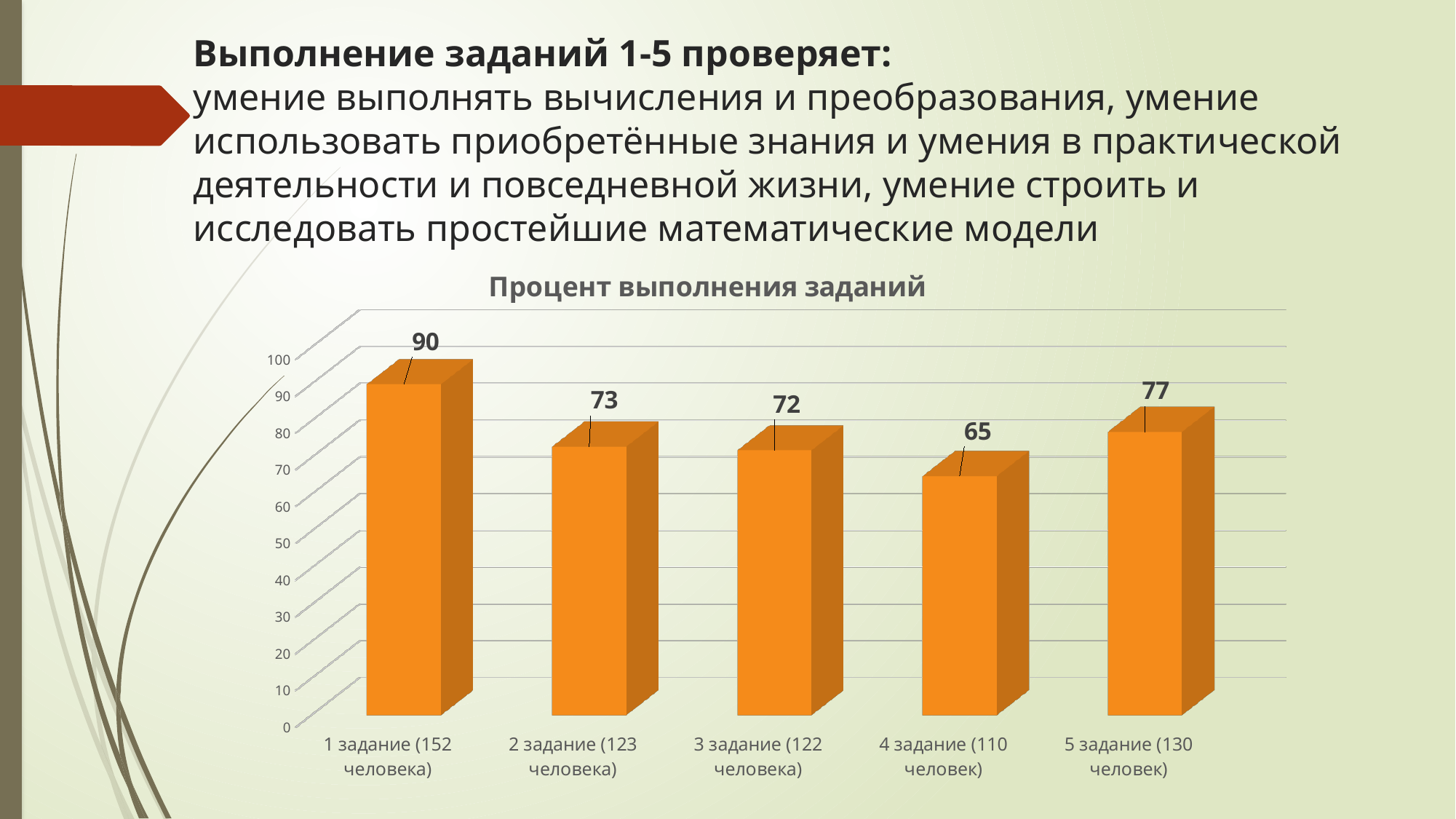
How many categories are shown in the chart? 5 What is the value for "1 задание (152 человека)"? 90 Is the value for "2 задание (123 человека)" greater or less than 80? less Which is larger, the value for "5 задание (130 человек)" or "3 задание (122 человека)"? 5 задание (130 человек) Which category has the highest value? 1 задание (152 человека) Which category has the lowest value? 4 задание (110 человек) What is the title of the chart? Процент выполнения заданий What is the value for "4 задание (110 человек)"? 65 What kind of chart is shown on the slide? bar chart What is the difference between the values for "5 задание (130 человек)" and "2 задание (123 человека)"? 4 What is the difference between the values for "1 задание (152 человека)" and "4 задание (110 человек)"? 25 What is the value for "5 задание (130 человек)"? 77